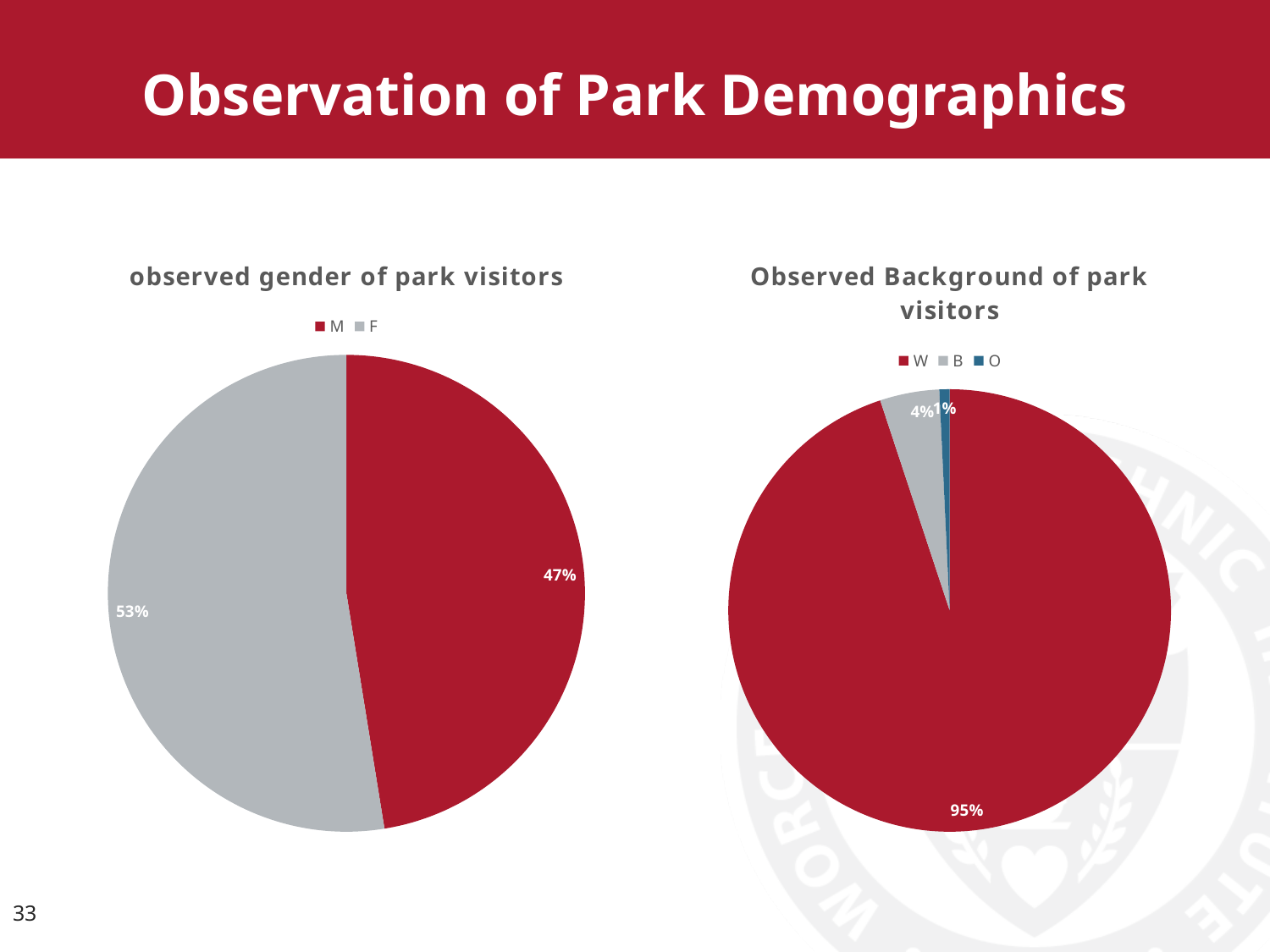
In the 'Observed Background of park visitors' chart, which category has the smallest share? O In the 'observed gender of park visitors' chart, what is the difference between the F and M shares? 6% What kind of chart is the 'observed gender of park visitors' chart? Pie chart In the 'observed gender of park visitors' chart, what share of visitors is M? 47% In the 'observed gender of park visitors' chart, which category has the larger share? F In the 'Observed Background of park visitors' chart, how many categories does the legend list? 3 How many categories does the legend of the 'observed gender of park visitors' chart list? 2 In the 'Observed Background of park visitors' chart, what is the difference between the W and B shares? 91% In the 'Observed Background of park visitors' chart, what share of visitors is O? 1% In the 'Observed Background of park visitors' chart, what share of visitors is B? 4%